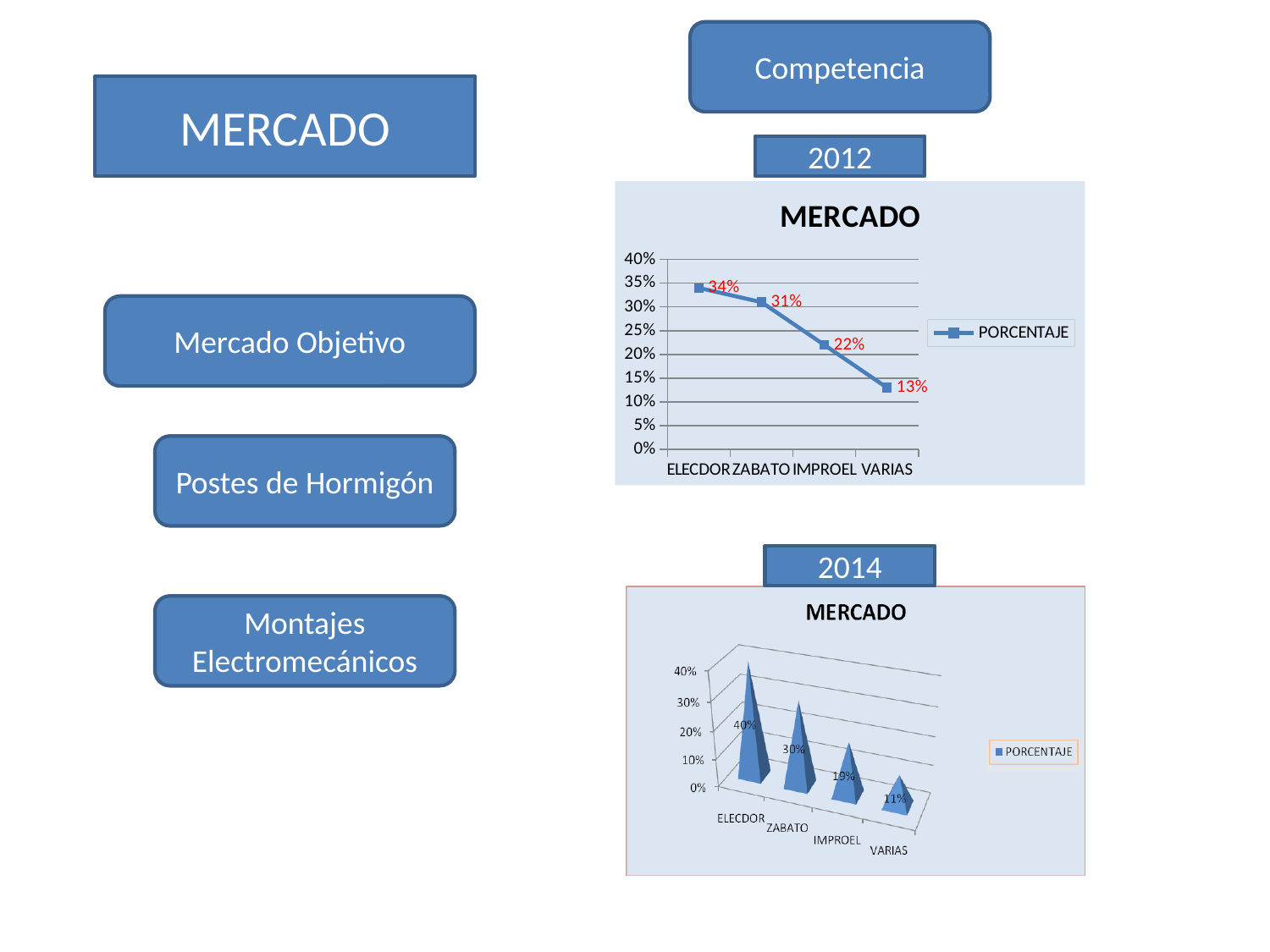
In the 2014 MERCADO chart, what is the value for ELECDOR? 40% In the 2014 MERCADO chart, which category has the highest value? ELECDOR In the 2014 MERCADO chart, which is larger, ZABATO or IMPROEL? ZABATO In the 2012 MERCADO chart, do the values rise or fall from ELECDOR to VARIAS? fall In the 2014 MERCADO chart, what is the value for VARIAS? 11% In the 2012 MERCADO chart, what is the value for IMPROEL? 22% In the 2012 MERCADO chart, what is the difference between ZABATO and VARIAS? 18% What kind of chart is the 2012 MERCADO chart? line chart How many series does the legend of the 2014 MERCADO chart list? 1 How many categories are shown in the 2012 MERCADO chart? 4 In the 2012 MERCADO chart, which category has the lowest value? VARIAS In the 2012 MERCADO chart, what is the value for ELECDOR? 34%